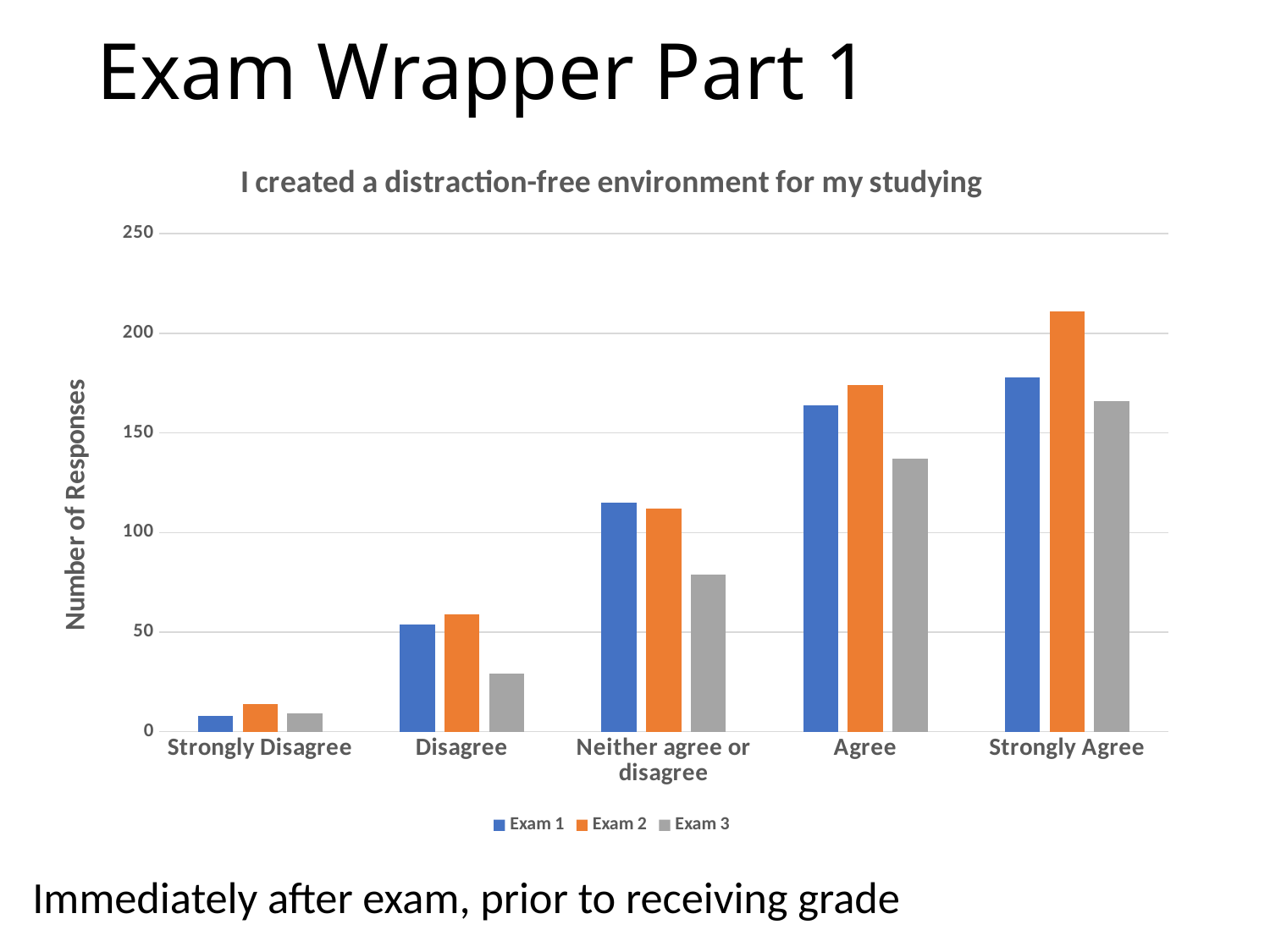
Is the value for Exam 3 in the Neither agree or disagree category greater or less than 100? less Do the Exam 1 values rise or fall moving from Strongly Disagree to Strongly Agree? rise What is the title of the chart? I created a distraction-free environment for my studying What is the label on the vertical axis? Number of Responses Is the value for Exam 3 in the Agree category greater or less than 150? less What kind of chart is shown on the slide? bar chart How many series does the legend list? 3 In the Agree category, which is larger: the value for Exam 1 or the value for Exam 3? Exam 1 For Exam 3, which category has the lowest number of responses? Strongly Disagree For Exam 2, which category has the highest number of responses? Strongly Agree How many response categories are shown on the x axis? 5 Is the value for Exam 2 in the Strongly Agree category greater or less than 200? greater